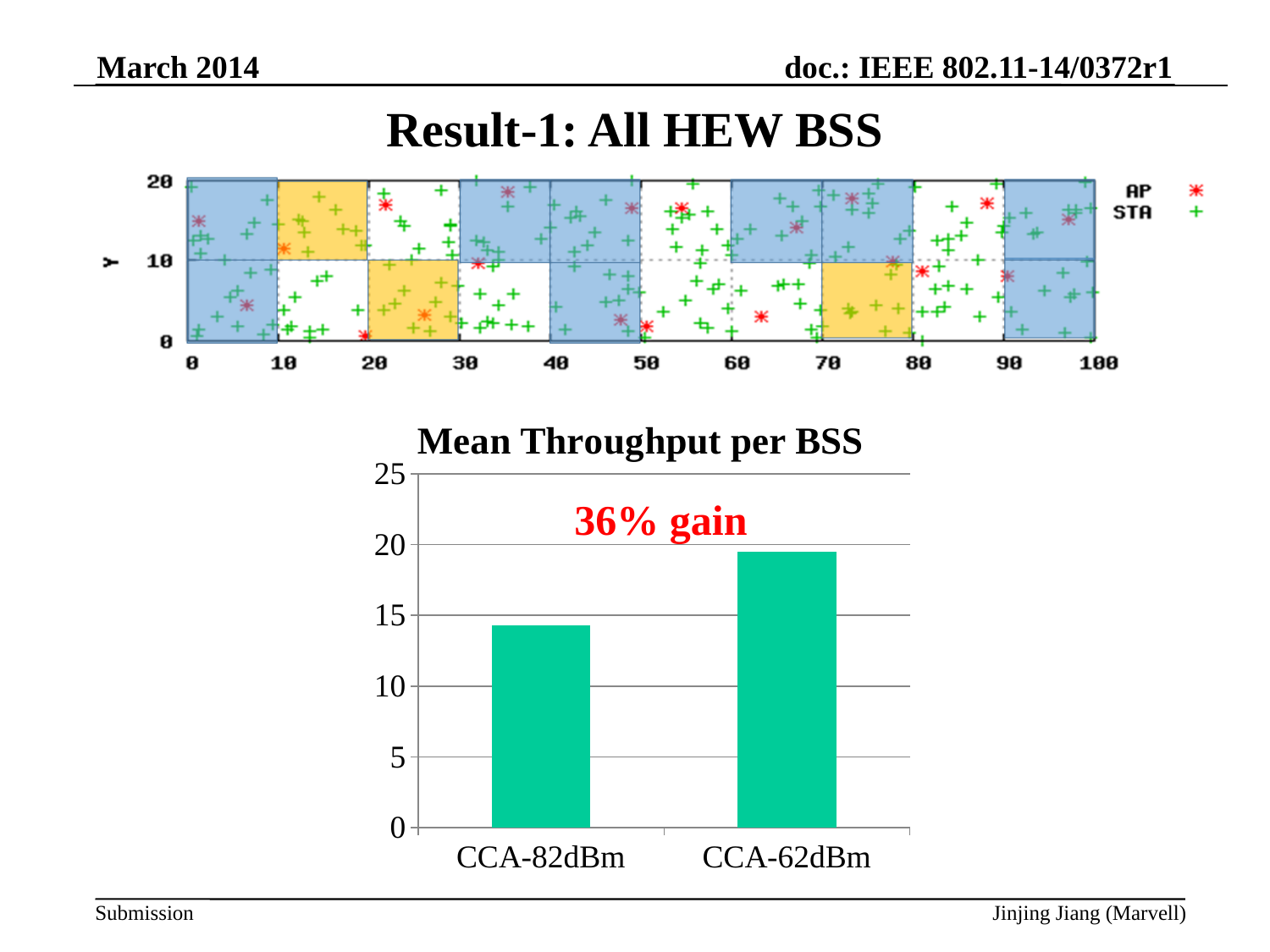
What gain percentage is annotated on the Mean Throughput per BSS chart? 36% gain In the Mean Throughput per BSS chart, which category has the lowest value? CCA-82dBm In the Mean Throughput per BSS chart, do the values rise or fall from left to right along the x axis? rise In the Mean Throughput per BSS chart, is the value for CCA-62dBm greater or less than 20? less In the scatter plot at the top of the slide, what two entries does the legend list? AP and STA In the Mean Throughput per BSS chart, what kind of chart is shown? bar chart In the Mean Throughput per BSS chart, is the value for CCA-62dBm greater or less than 15? greater In the Mean Throughput per BSS chart, which category has the highest value? CCA-62dBm In the Mean Throughput per BSS chart, how many categories are plotted? 2 In the Mean Throughput per BSS chart, which is larger, the value for CCA-82dBm or the value for CCA-62dBm? CCA-62dBm In the Mean Throughput per BSS chart, is the value for CCA-82dBm greater or less than 10? greater